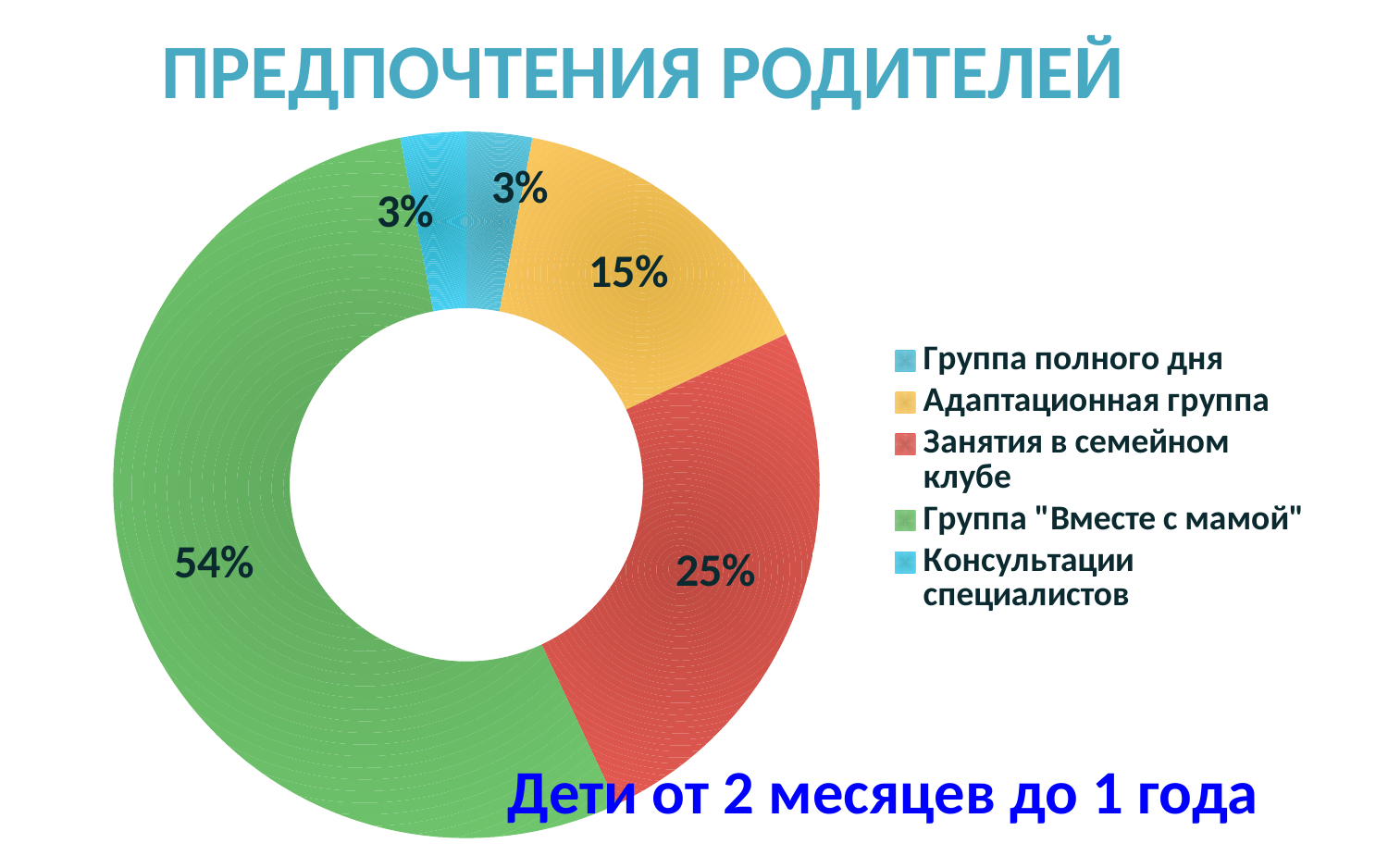
What colour represents Занятия в семейном клубе in the chart? red What percentage is shown for Группа полного дня? 3% Which is larger: Адаптационная группа or Занятия в семейном клубе? Занятия в семейном клубе How many categories does the legend list? 5 What percentage is shown for Адаптационная группа? 15% What kind of chart is shown on the slide? doughnut chart Which category has the largest share of the chart? Группа "Вместе с мамой" What percentage is shown for Консультации специалистов? 3% What percentage is shown for Группа "Вместе с мамой"? 54% What is the difference in percentage points between Группа "Вместе с мамой" and Занятия в семейном клубе? 29 What percentage is shown for Занятия в семейном клубе? 25% What is the title of the chart? ПРЕДПОЧТЕНИЯ РОДИТЕЛЕЙ